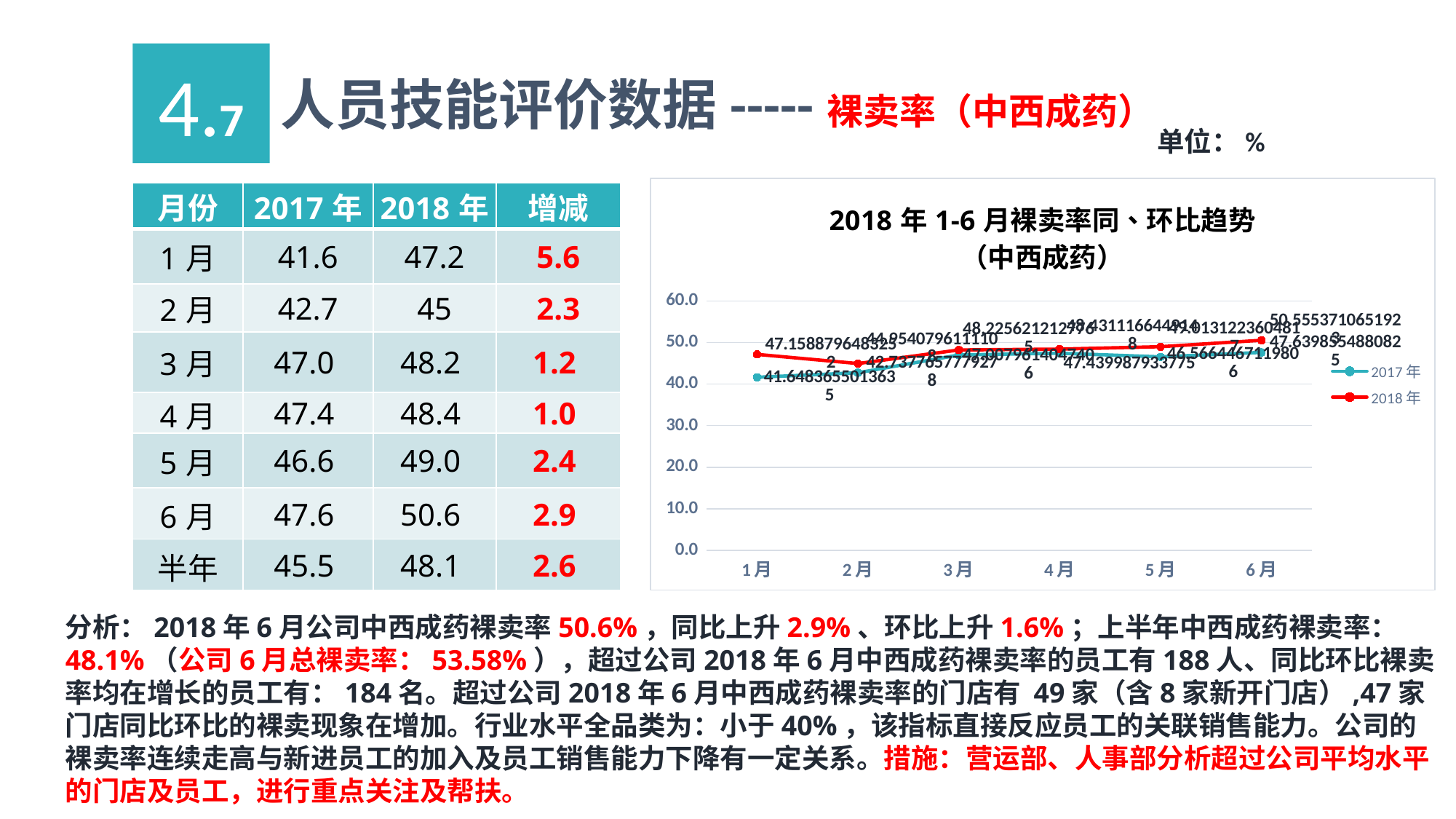
Which series in the chart is drawn in red? 2018年 Is the 2017年 value for 1月 greater or less than 50.0? less Does the 2018年 series rise or fall from 2月 to 6月? rise For 6月, which series has the larger value, 2017年 or 2018年? 2018年 How many months are plotted along the x axis of the chart? 6 For 1月, which series has the larger value, 2017年 or 2018年? 2018年 In which month is the 2018年 series at its lowest? 2月 What is the title of the chart? 2018年1-6月裸卖率同、环比趋势（中西成药） How many series does the chart legend list? 2 What kind of chart is shown on the slide? line chart Is the 2018年 value for 1月 greater or less than 40.0? greater In which month is the 2018年 series at its highest? 6月